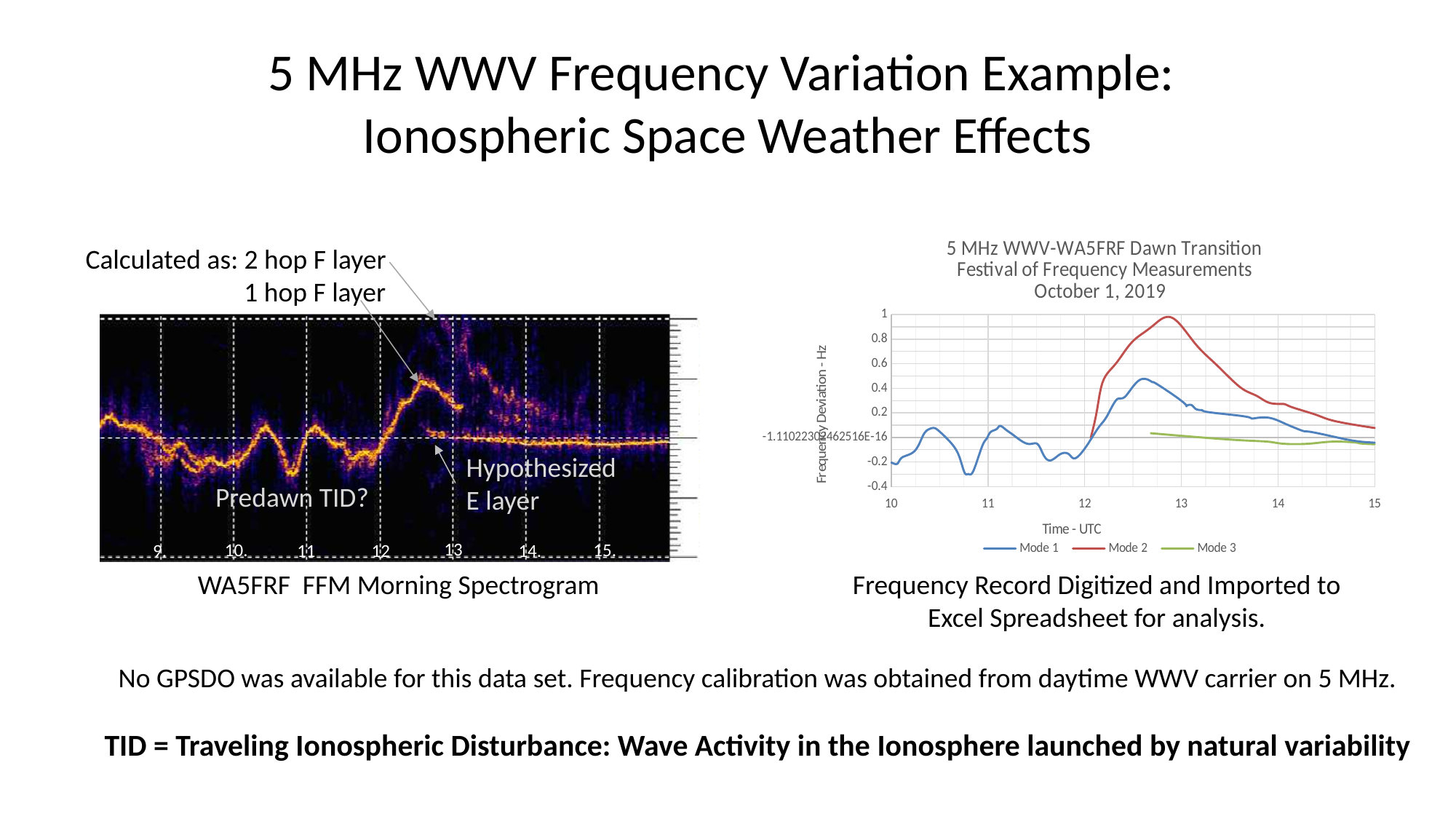
In the '5 MHz WWV-WA5FRF Dawn Transition' chart, is the lowest value of Mode 1 (near 10.8 UTC) greater or less than -0.2 Hz? less In the '5 MHz WWV-WA5FRF Dawn Transition' chart, which series reaches the highest frequency deviation? Mode 2 In the '5 MHz WWV-WA5FRF Dawn Transition' chart, is the peak value of Mode 1 greater or less than 0.6 Hz? less In the '5 MHz WWV-WA5FRF Dawn Transition' chart, which series reaches the lowest frequency deviation? Mode 1 How many series does the legend of the '5 MHz WWV-WA5FRF Dawn Transition' chart list? 3 In the '5 MHz WWV-WA5FRF Dawn Transition' chart, does Mode 3 ever rise above 0.2 Hz? No What colour is the Mode 2 line in the '5 MHz WWV-WA5FRF Dawn Transition' chart? red What is the x-axis label of the '5 MHz WWV-WA5FRF Dawn Transition' chart? Time - UTC In the '5 MHz WWV-WA5FRF Dawn Transition' chart, does the Mode 2 line rise or fall between 13 and 15 UTC? fall What kind of chart is the '5 MHz WWV-WA5FRF Dawn Transition' chart on the right of the slide? line chart In the '5 MHz WWV-WA5FRF Dawn Transition' chart, at 13 UTC, which series has the larger frequency deviation, Mode 1 or Mode 2? Mode 2